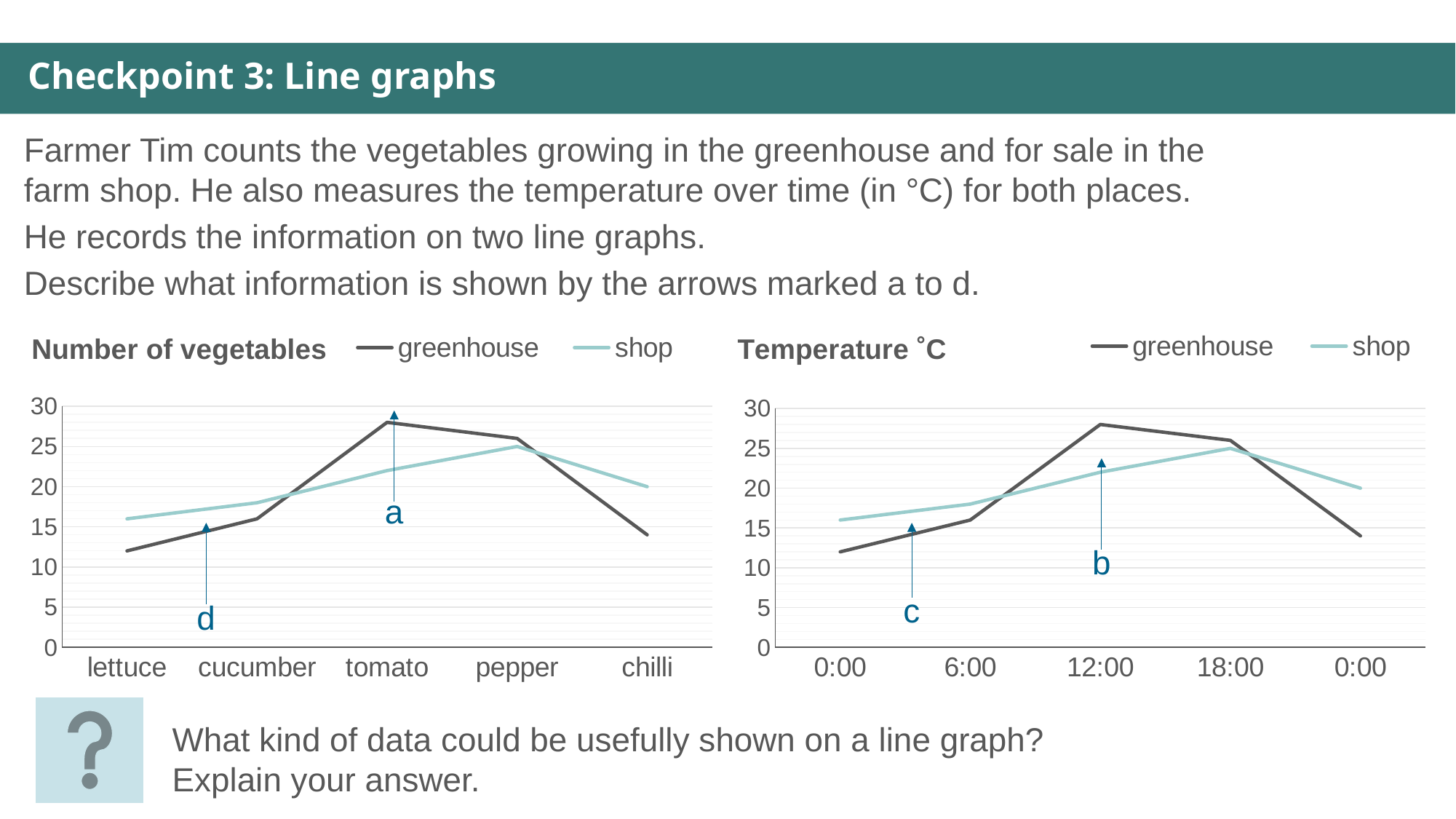
In the Temperature °C chart, what is the shop temperature at 18:00? 25 In the Number of vegetables chart, is the greenhouse value for tomato greater or less than 25? greater How many categories are shown on the x axis of the Number of vegetables chart? 5 What type of chart is the Number of vegetables chart? line chart In the Temperature °C chart, does the greenhouse line rise or fall from 18:00 to the final 0:00? fall In the Number of vegetables chart, which vegetable has the highest greenhouse value? tomato In the Number of vegetables chart, what is the shop value for chilli? 20 In the Temperature °C chart, is the greenhouse temperature at 0:00 (the first point) greater or less than 15? less In the Number of vegetables chart, what is the shop value for pepper? 25 In the Number of vegetables chart, which series has the larger value for chilli, greenhouse or shop? shop How many series does the legend of the Temperature °C chart list? 2 In the Number of vegetables chart, which vegetable has the lowest greenhouse value? lettuce